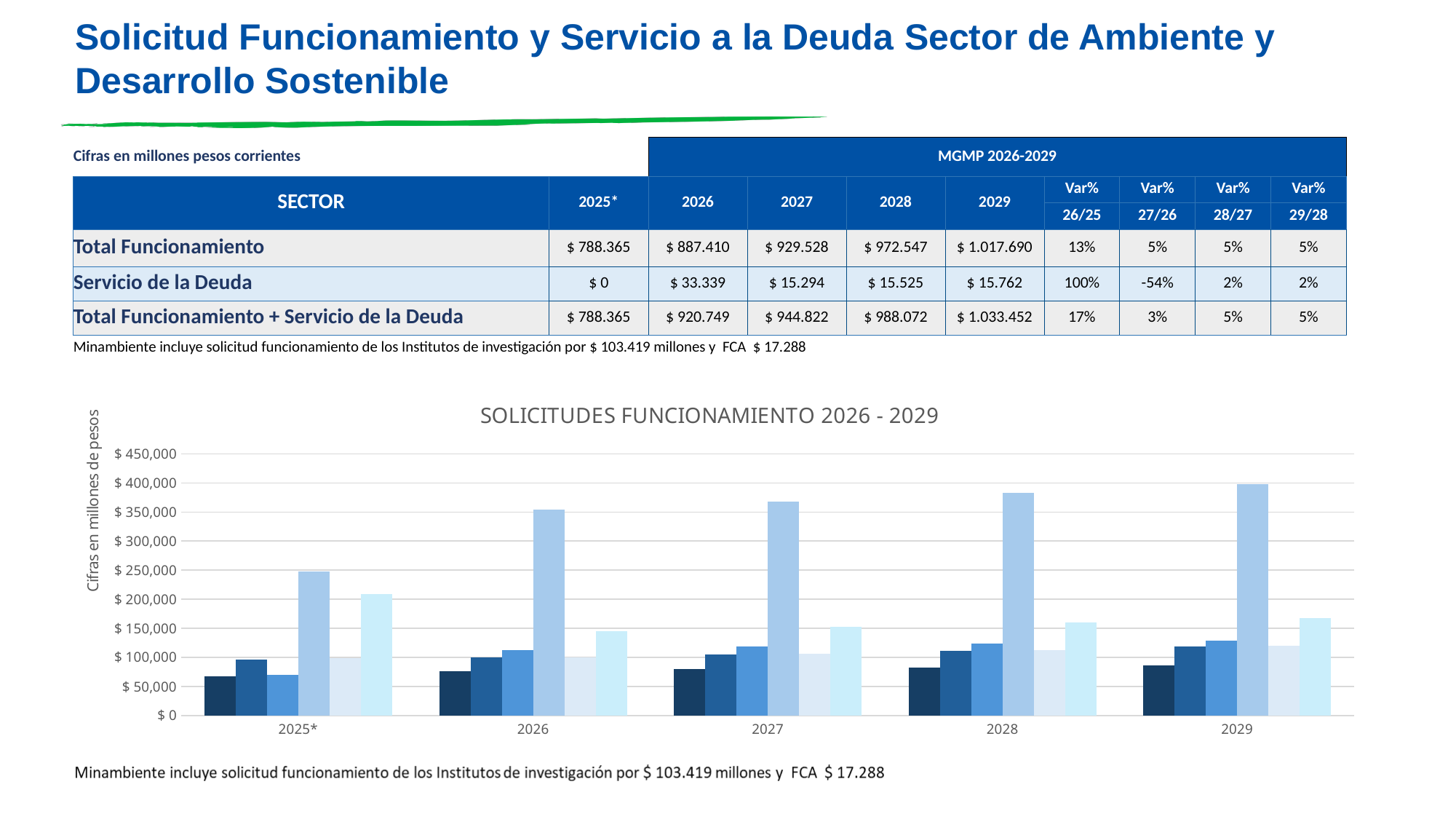
Does the tallest bar in each group rise or fall from 2025* to 2029? rise How many bars are plotted in each year group of the chart? 6 Is the first (darkest) bar in the 2026 group greater or less than $ 100,000? less What kind of chart is shown on the slide? bar chart Which year group contains the tallest bar in the chart? 2029 What is the title of the chart? SOLICITUDES FUNCIONAMIENTO 2026 - 2029 Which is larger: the tallest bar in the 2025* group or the tallest bar in the 2029 group? 2029 How many year categories are shown on the x axis of the chart? 5 Is the tallest bar in the 2029 group greater or less than $ 350,000? greater What is the label of the vertical axis of the chart? Cifras en millones de pesos Is the tallest bar in the 2025* group greater or less than $ 300,000? less Which year group has the lowest tallest bar in the chart? 2025*